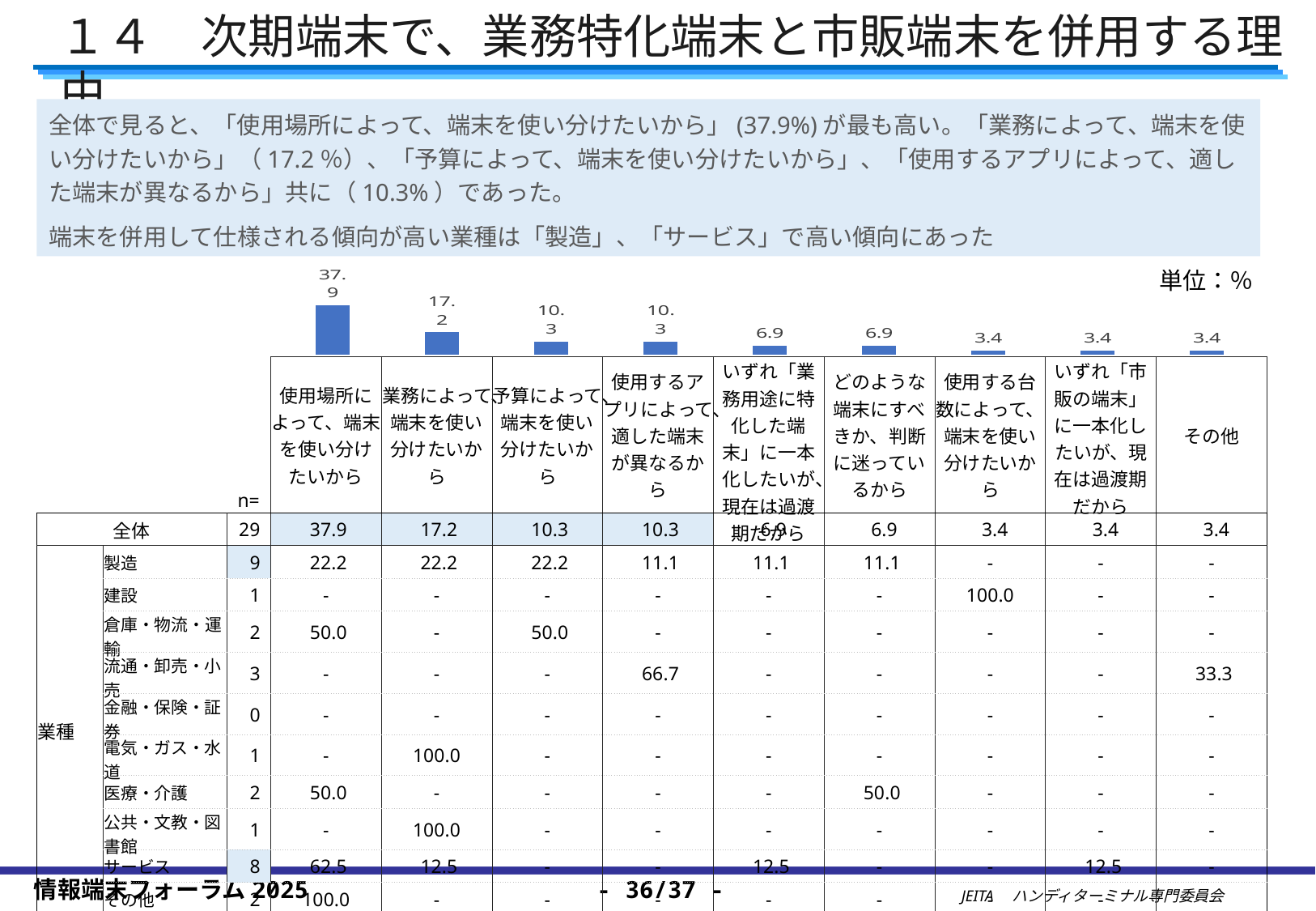
What kind of chart is shown above the table on the slide? bar chart What unit is indicated for the chart values on the slide? % Which category has the highest bar in the chart? 使用場所によって、端末を使い分けたいから What is the value of the bar for 「どのような端末にすべきか、判断に迷っているから」? 6.9 What is the value of the bar for 「業務によって、端末を使い分けたいから」? 17.2 What is the difference between the bar for 「使用場所によって、端末を使い分けたいから」 and the bar for 「業務によって、端末を使い分けたいから」? 20.7 How many bars does the chart above the table contain? 9 Which is larger: the bar for 「業務によって、端末を使い分けたいから」 or the bar for 「使用するアプリによって、適した端末が異なるから」? 業務によって、端末を使い分けたいから What is the value of the bar for 「使用場所によって、端末を使い分けたいから」? 37.9 What is the value of the bar for 「その他」? 3.4 What is the value of the bar for 「予算によって、端末を使い分けたいから」? 10.3 Do the bar values rise or fall from left to right across the chart? fall